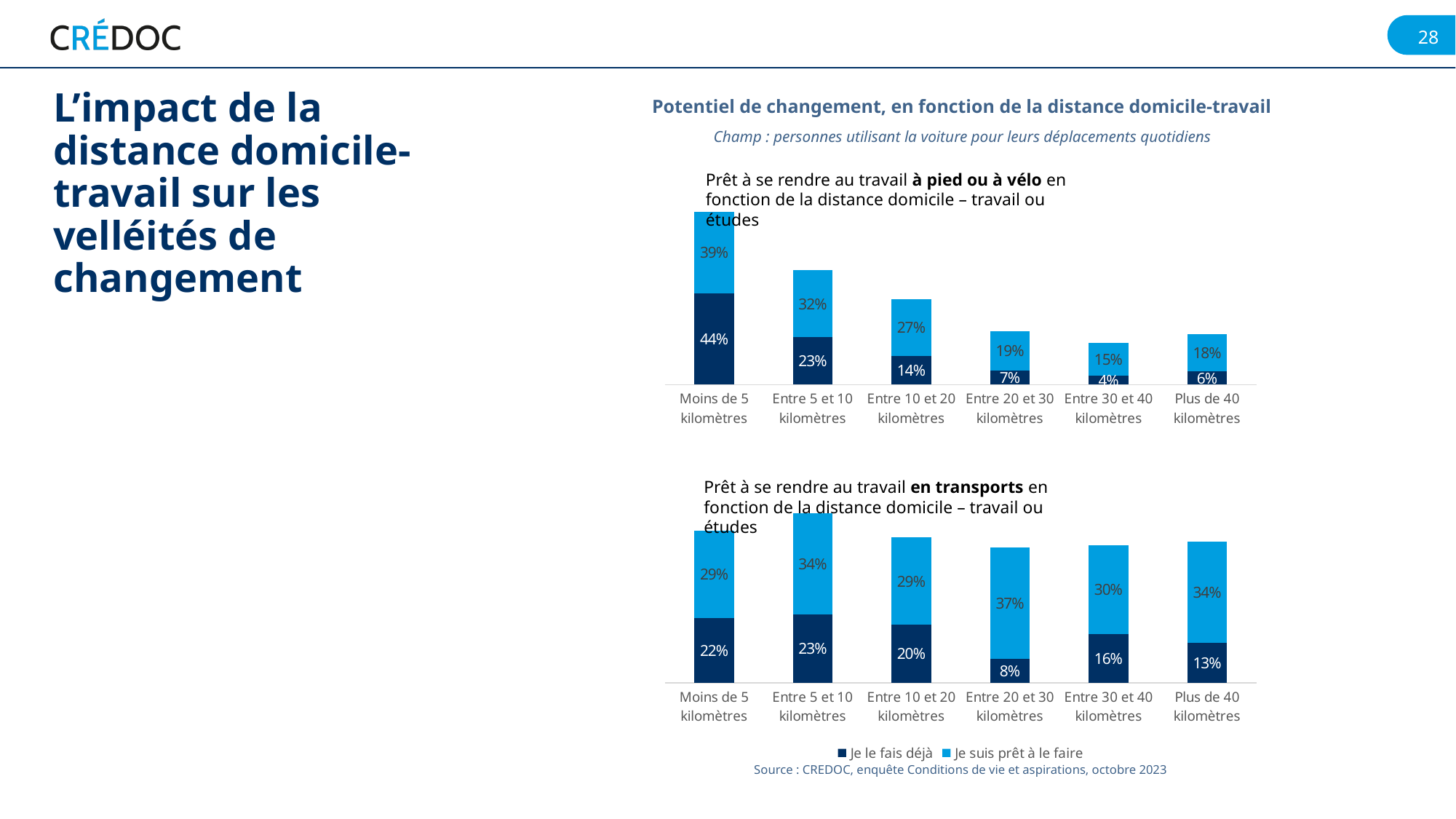
In the top chart (à pied ou à vélo), which distance category has the lowest 'Je le fais déjà' value? Entre 30 et 40 kilomètres In the bottom chart (en transports), which is larger: 'Je le fais déjà' for 'Entre 30 et 40 kilomètres' or for 'Entre 20 et 30 kilomètres'? Entre 30 et 40 kilomètres In the bottom chart (en transports), what is the value of 'Je le fais déjà' for 'Plus de 40 kilomètres'? 13% In the top chart (à pied ou à vélo), what is the total of the stacked bar for 'Moins de 5 kilomètres'? 83% How many series does the legend list for the charts? 2 In the bottom chart (en transports), what is the value of 'Je suis prêt à le faire' for 'Entre 20 et 30 kilomètres'? 37% How many distance categories are shown on the x axis of the top chart (à pied ou à vélo)? 6 In the top chart (à pied ou à vélo), what is the value of 'Je suis prêt à le faire' for 'Entre 10 et 20 kilomètres'? 27% In the bottom chart (en transports), which distance category has the highest 'Je suis prêt à le faire' value? Entre 20 et 30 kilomètres In the bottom chart (en transports), what is the total of the stacked bar for 'Entre 5 et 10 kilomètres'? 57% In the top chart (à pied ou à vélo), what is the difference between the 'Je le fais déjà' values for 'Moins de 5 kilomètres' and 'Entre 5 et 10 kilomètres'? 21 percentage points In the top chart (à pied ou à vélo), what is the value of 'Je le fais déjà' for 'Moins de 5 kilomètres'? 44%